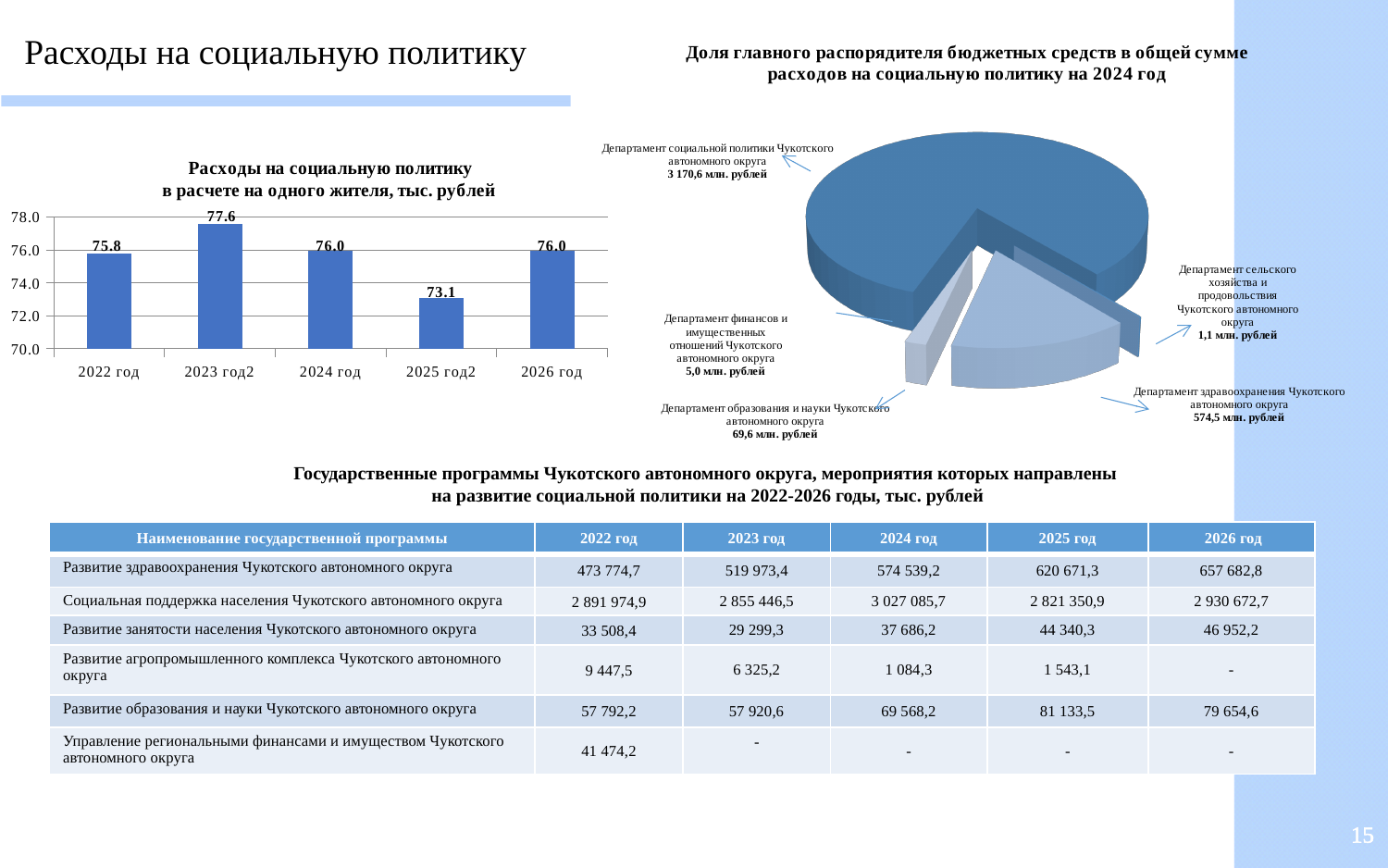
In the pie chart 'Доля главного распорядителя бюджетных средств в общей сумме расходов на социальную политику на 2024 год', what is the value for Департамент социальной политики Чукотского автономного округа? 3 170,6 млн. рублей In the bar chart 'Расходы на социальную политику в расчете на одного жителя, тыс. рублей', what is the difference between the values for 2023 год2 and 2025 год2? 4.5 In the bar chart 'Расходы на социальную политику в расчете на одного жителя, тыс. рублей', what is the value for 2025 год2? 73.1 In the bar chart 'Расходы на социальную политику в расчете на одного жителя, тыс. рублей', how many bars are plotted? 5 In the bar chart 'Расходы на социальную политику в расчете на одного жителя, тыс. рублей', which is larger: the value for 2022 год or the value for 2024 год? 2024 год In the pie chart 'Доля главного распорядителя бюджетных средств в общей сумме расходов на социальную политику на 2024 год', how many slices are labelled? 5 In the bar chart 'Расходы на социальную политику в расчете на одного жителя, тыс. рублей', which year has the highest value? 2023 год2 What type of chart is 'Расходы на социальную политику в расчете на одного жителя, тыс. рублей'? Bar chart In the bar chart 'Расходы на социальную политику в расчете на одного жителя, тыс. рублей', which year has the lowest value? 2025 год2 In the pie chart 'Доля главного распорядителя бюджетных средств в общей сумме расходов на социальную политику на 2024 год', what is the value for Департамент здравоохранения Чукотского автономного округа? 574,5 млн. рублей In the bar chart 'Расходы на социальную политику в расчете на одного жителя, тыс. рублей', what is the value for 2022 год? 75.8 In the pie chart 'Доля главного распорядителя бюджетных средств в общей сумме расходов на социальную политику на 2024 год', which department has the smallest value? Департамент сельского хозяйства и продовольствия Чукотского автономного округа